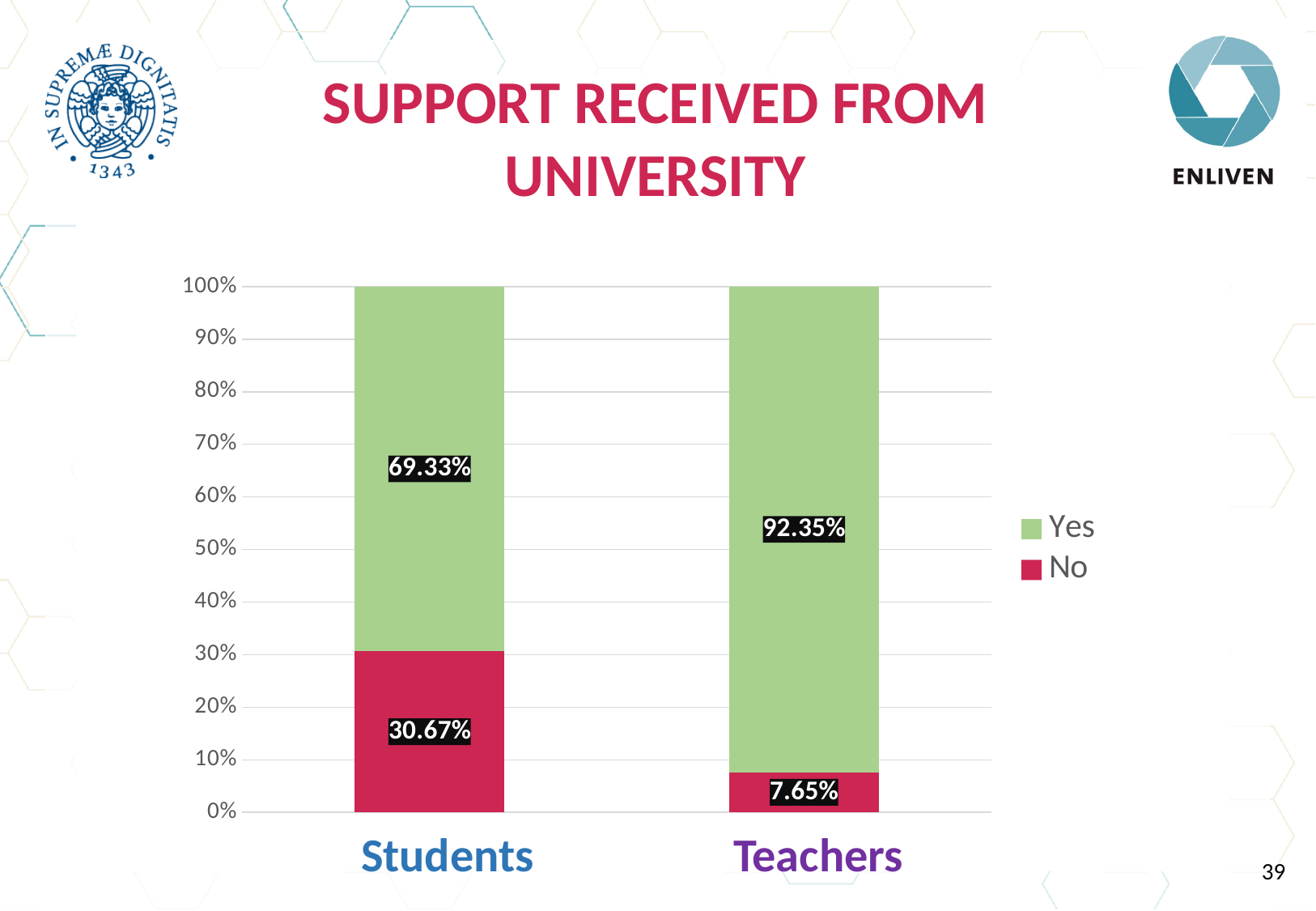
What kind of chart is shown on the slide? Stacked bar chart Which group has the lowest No percentage? Teachers What percentage of Students answered Yes? 69.33% Which group has the higher Yes percentage, Students or Teachers? Teachers What is the difference between the Yes percentages for Teachers and Students? 23.02% What percentage of Teachers answered No? 7.65% What is the total of the Students bar (Yes plus No)? 100% How many groups are shown on the x axis? 2 What percentage of Teachers answered Yes? 92.35% What is the title of the chart? SUPPORT RECEIVED FROM UNIVERSITY How many series does the legend list? 2 What percentage of Students answered No? 30.67%